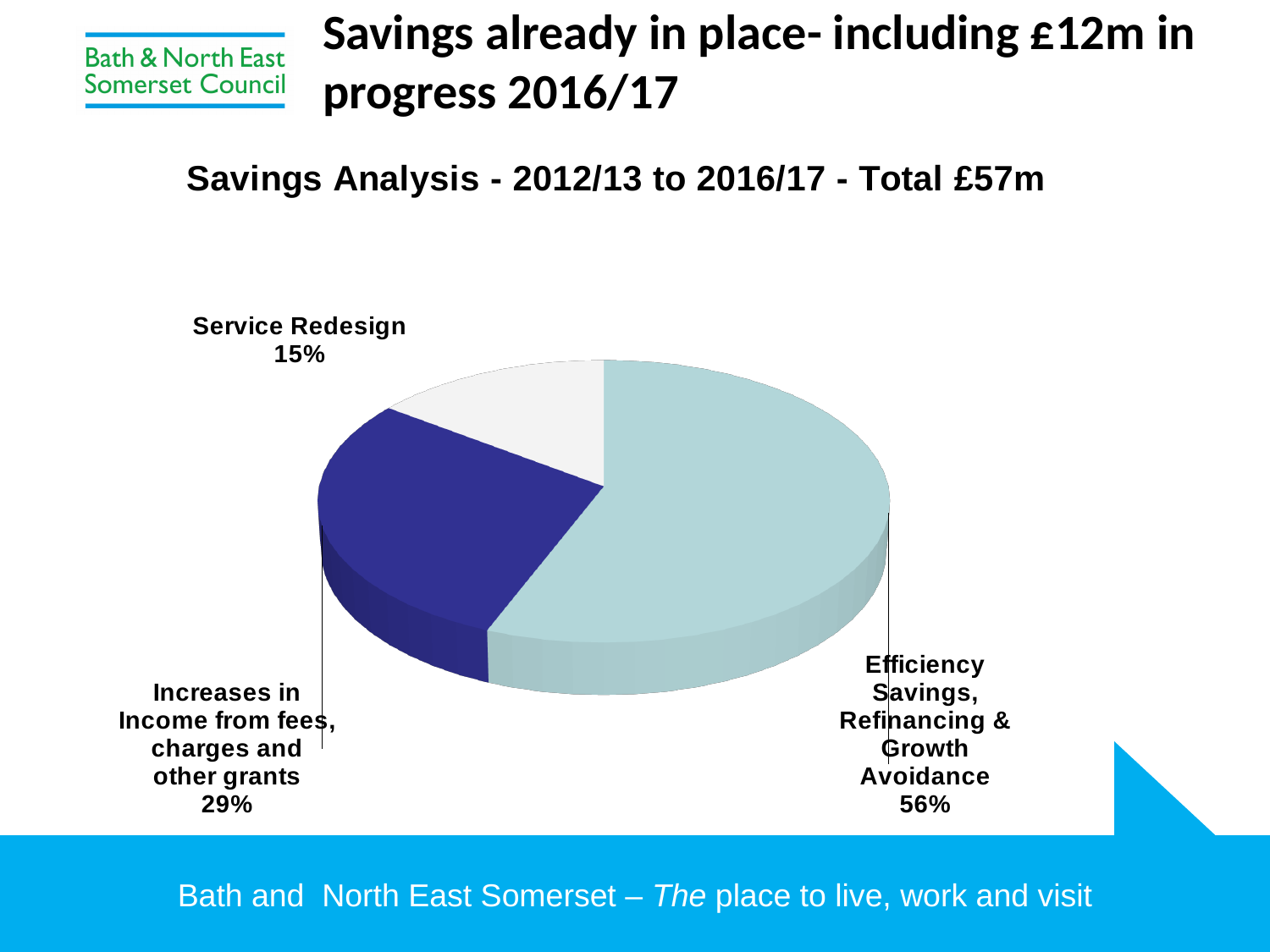
What is the difference in percentage points between the Increases in Income from fees, charges and other grants slice and the Service Redesign slice? 14 percentage points What kind of chart is shown on the slide? pie chart How many slices does the pie chart have? 3 What share of the pie does Efficiency Savings, Refinancing & Growth Avoidance represent? 56% What is the difference in percentage points between the Efficiency Savings, Refinancing & Growth Avoidance slice and the Increases in Income from fees, charges and other grants slice? 27 percentage points Which category has the smallest slice of the pie? Service Redesign What share of the pie does Service Redesign represent? 15% What colour is the Efficiency Savings, Refinancing & Growth Avoidance slice? light blue Which category has the largest slice of the pie? Efficiency Savings, Refinancing & Growth Avoidance What share of the pie does Increases in Income from fees, charges and other grants represent? 29% What is the title of the chart? Savings Analysis - 2012/13 to 2016/17 - Total £57m Which is larger: the Service Redesign slice or the Increases in Income from fees, charges and other grants slice? Increases in Income from fees, charges and other grants